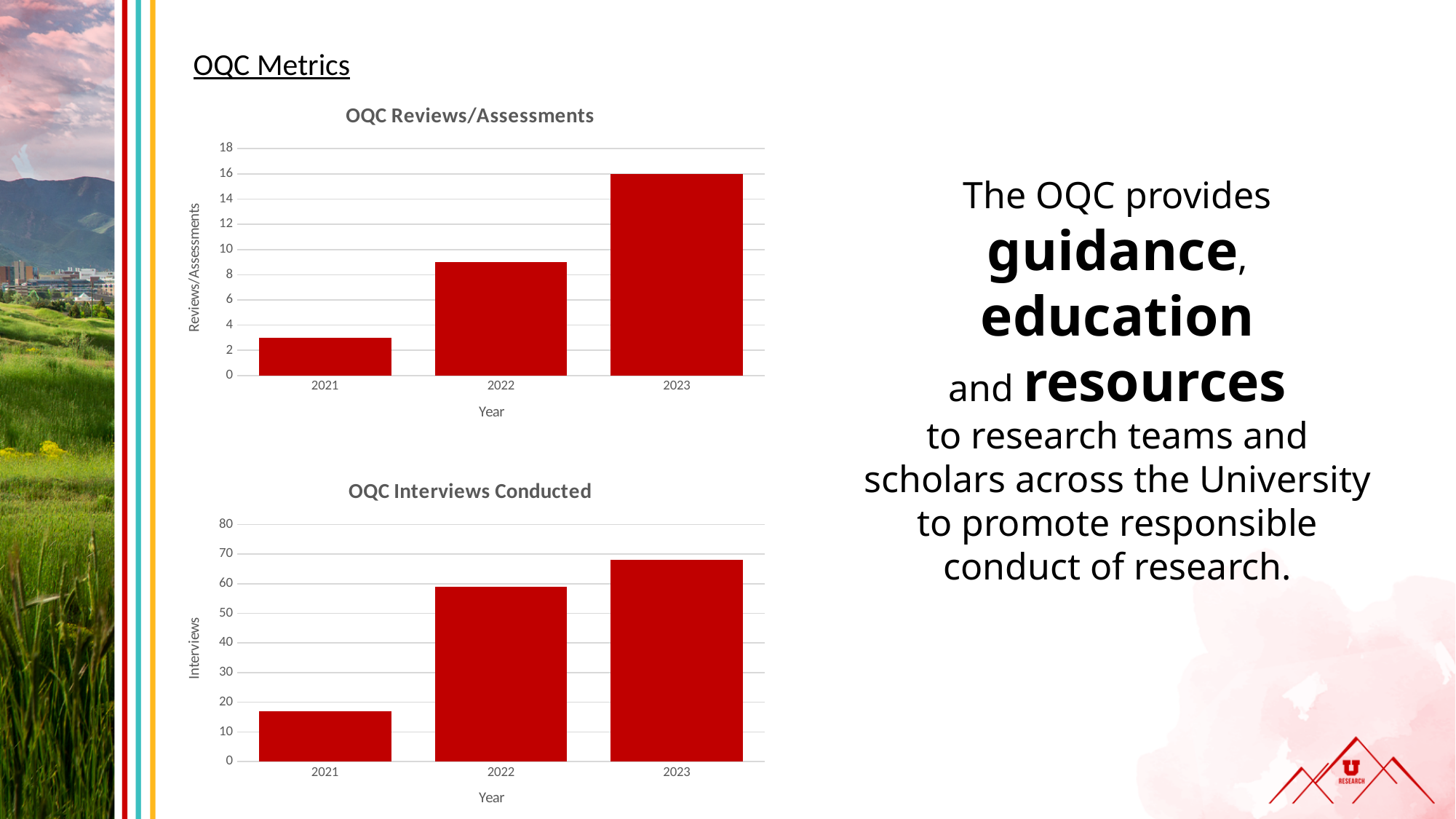
In the OQC Interviews Conducted chart, which is larger, the value for 2021 or the value for 2022? 2022 In the OQC Interviews Conducted chart, do the values rise or fall from 2021 to 2023? rise In the OQC Reviews/Assessments chart, which year has the lowest value? 2021 In the OQC Reviews/Assessments chart, which year has the highest value? 2023 In the OQC Reviews/Assessments chart, is the value for 2021 greater or less than 4? less What kind of chart is the OQC Interviews Conducted chart? bar chart In the OQC Reviews/Assessments chart, is the value for 2022 greater or less than 8? greater How many years are shown in the OQC Reviews/Assessments chart? 3 In the OQC Reviews/Assessments chart, what is the value for 2023? 16 In the OQC Interviews Conducted chart, is the value for 2022 greater or less than 50? greater In the OQC Interviews Conducted chart, which year has the highest value? 2023